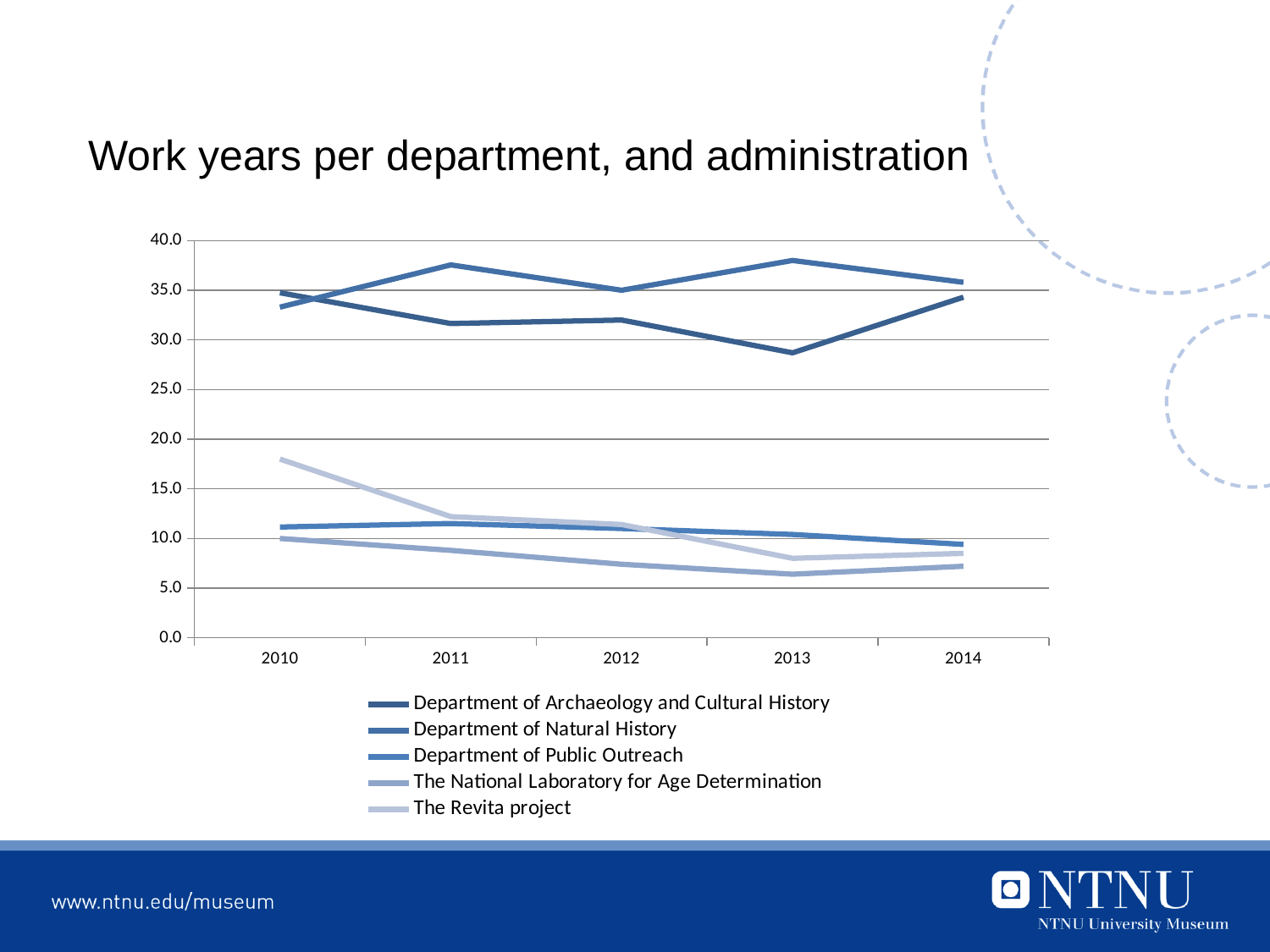
Is the value for The Revita project in 2010 greater or less than 15.0? greater Is the value for the Department of Natural History in 2013 greater or less than 35.0? greater How many years are shown on the x axis? 5 What kind of chart is shown on the slide? line chart Which series has the lowest value in 2013? The National Laboratory for Age Determination In 2011, which is larger: the Department of Natural History or the Department of Archaeology and Cultural History? Department of Natural History What is the title of the chart? Work years per department, and administration How many series does the legend list? 5 Is the value for the Department of Archaeology and Cultural History in 2013 greater or less than 30.0? less In which year is The Revita project at its highest? 2010 Does the value for The Revita project rise or fall from 2010 to 2013? fall Which series has the highest value in 2013? Department of Natural History